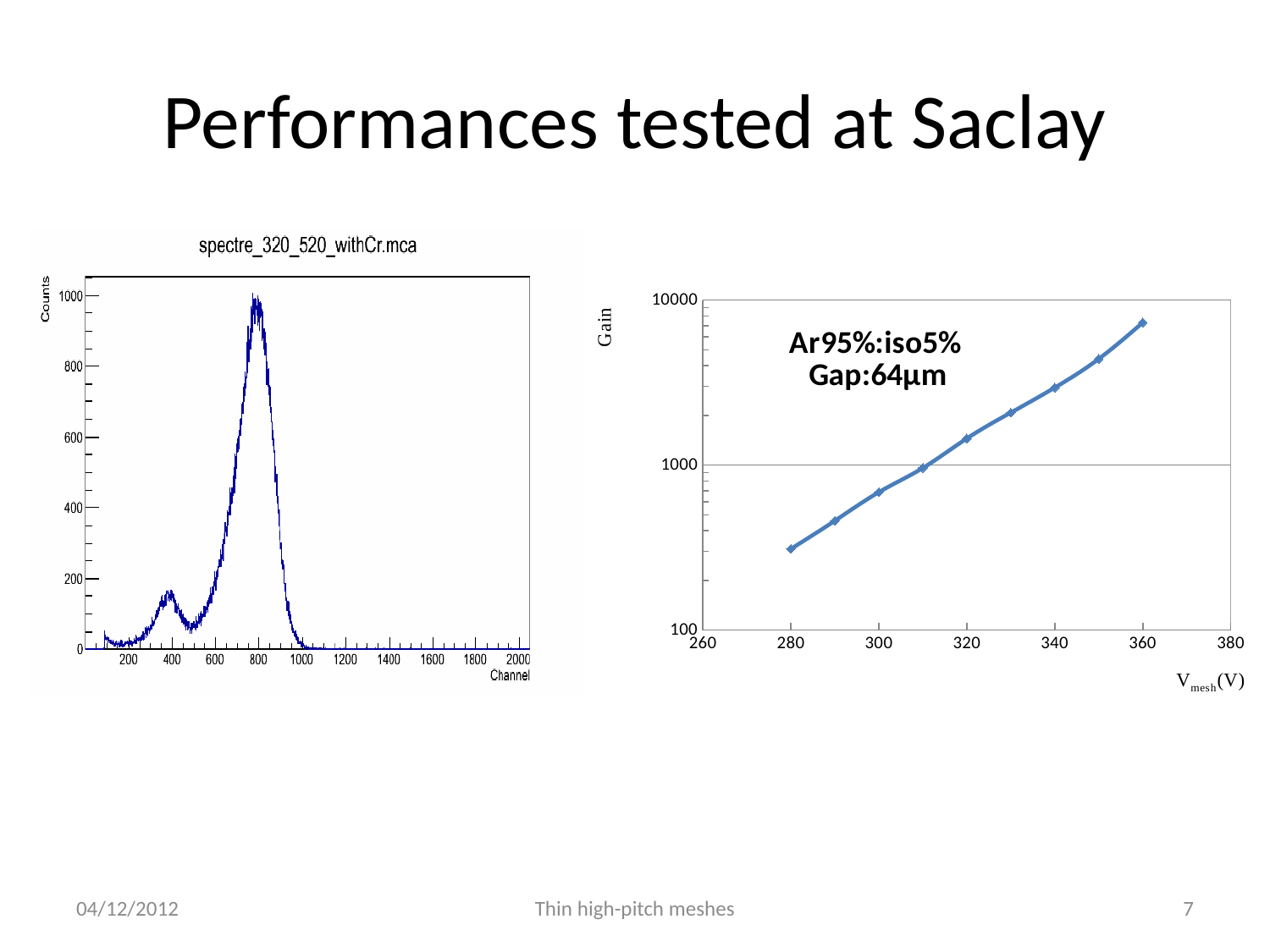
In the right-hand chart (Gain vs V_mesh), is the gain at V_mesh = 340 V greater or less than 1000? greater In the right-hand chart (Gain vs V_mesh), does the gain rise or fall as V_mesh increases? rise In the right-hand chart (Gain vs V_mesh), what gas mixture and gap are stated in the annotation? Ar95%:iso5%, Gap:64µm In the right-hand chart (Gain vs V_mesh), which has the larger gain: V_mesh = 300 V or V_mesh = 350 V? 350 V In the right-hand chart (Gain vs V_mesh), at which V_mesh value is the gain lowest? 280 In the right-hand chart (Gain vs V_mesh), how many data points are plotted? 9 In the right-hand chart (Gain vs V_mesh), what kind of chart is it? line chart In the right-hand chart (Gain vs V_mesh), is the gain at V_mesh = 360 V greater or less than 1000? greater In the right-hand chart (Gain vs V_mesh), at which V_mesh value is the gain highest? 360 In the left-hand chart (spectre_320_520_withCr.mca), is the peak count value greater or less than 800? greater In the left-hand chart, what is the title shown above the plot? spectre_320_520_withCr.mca